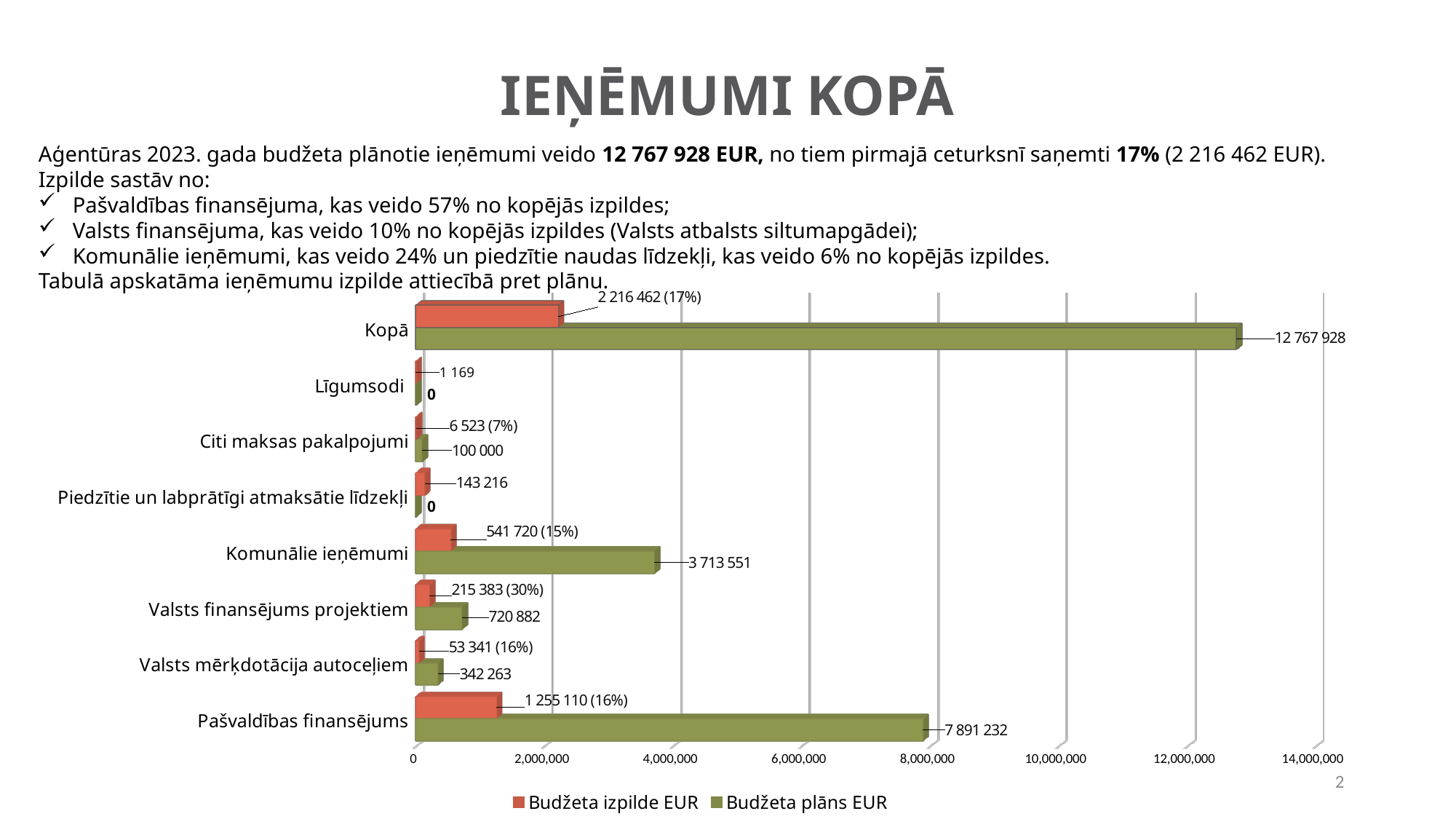
What is the Budžeta izpilde EUR data label for Valsts finansējums projektiem? 215 383 (30%) What is the Budžeta plāns EUR value for Valsts mērķdotācija autoceļiem? 342 263 What is the Budžeta plāns EUR value for Komunālie ieņēmumi? 3 713 551 What is the Budžeta izpilde EUR value for Līgumsodi? 1 169 How many categories are shown on the chart's vertical axis? 8 What type of chart is shown on the slide? bar chart How many series does the chart legend list? 2 Which is larger: the Budžeta plāns EUR value for Valsts finansējums projektiem or for Citi maksas pakalpojumi? Valsts finansējums projektiem What is the Budžeta plāns EUR value for Pašvaldības finansējums? 7 891 232 Excluding Kopā, which category has the highest Budžeta plāns EUR value? Pašvaldības finansējums Which series is shown in red in the chart? Budžeta izpilde EUR What is the difference between the Budžeta plāns EUR value and the Budžeta izpilde EUR value for Valsts mērķdotācija autoceļiem? 288 922